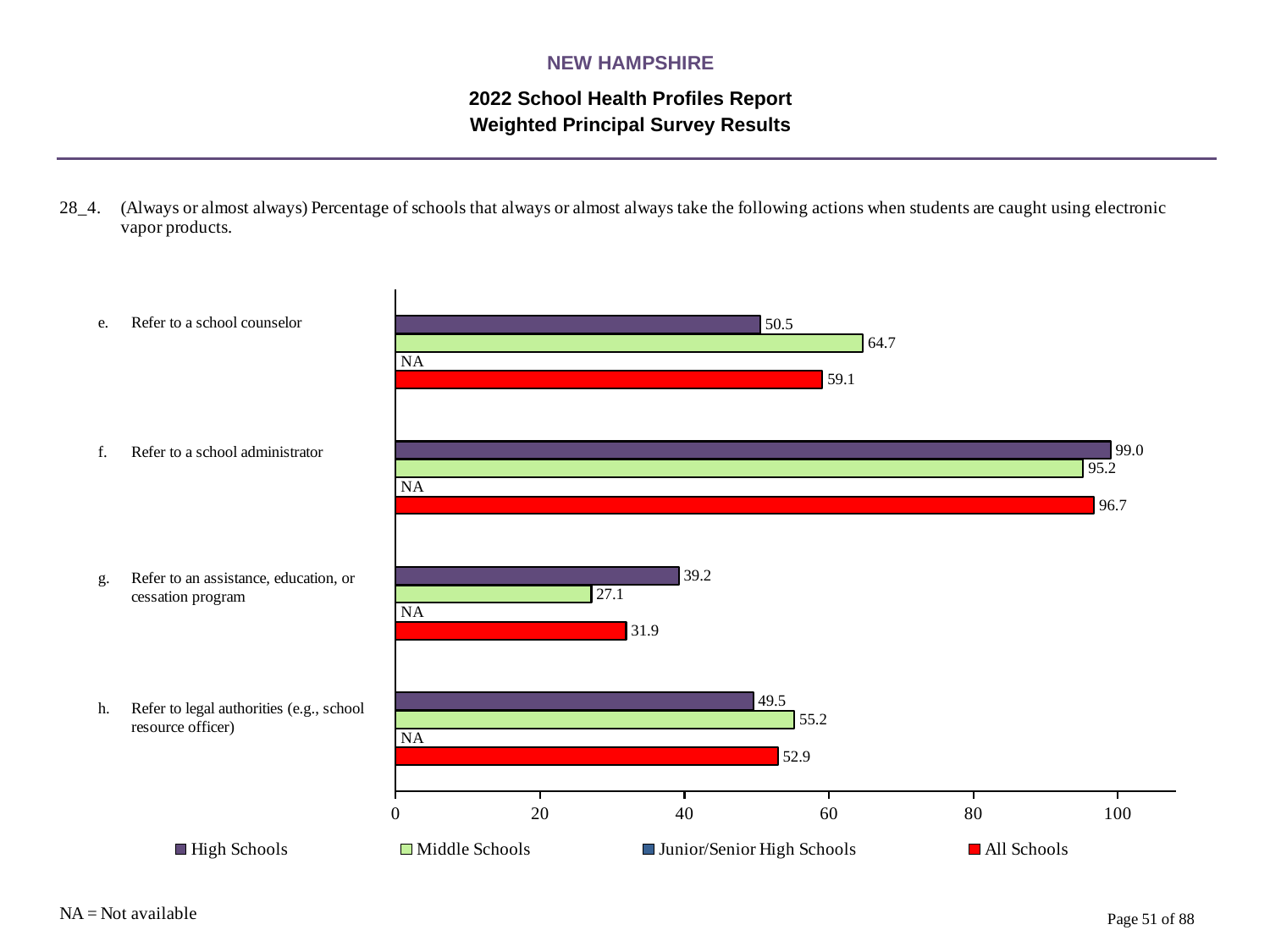
What is the High Schools value for "Refer to a school counselor"? 50.5 What is the difference between the High Schools and Middle Schools values for "Refer to a school counselor"? 14.2 What is the Middle Schools value for "Refer to legal authorities (e.g., school resource officer)"? 55.2 Which action has the highest High Schools value? Refer to a school administrator What kind of chart is shown on the slide? Bar chart What is the All Schools value for "Refer to a school administrator"? 96.7 Which action has the lowest All Schools value? Refer to an assistance, education, or cessation program For "Refer to legal authorities (e.g., school resource officer)", which is larger: the High Schools value or the Middle Schools value? Middle Schools What is the Middle Schools value for "Refer to an assistance, education, or cessation program"? 27.1 How many series does the legend list? 4 How many actions (categories) are shown on the chart? 4 What value is shown for the Junior/Senior High Schools series in each category? NA